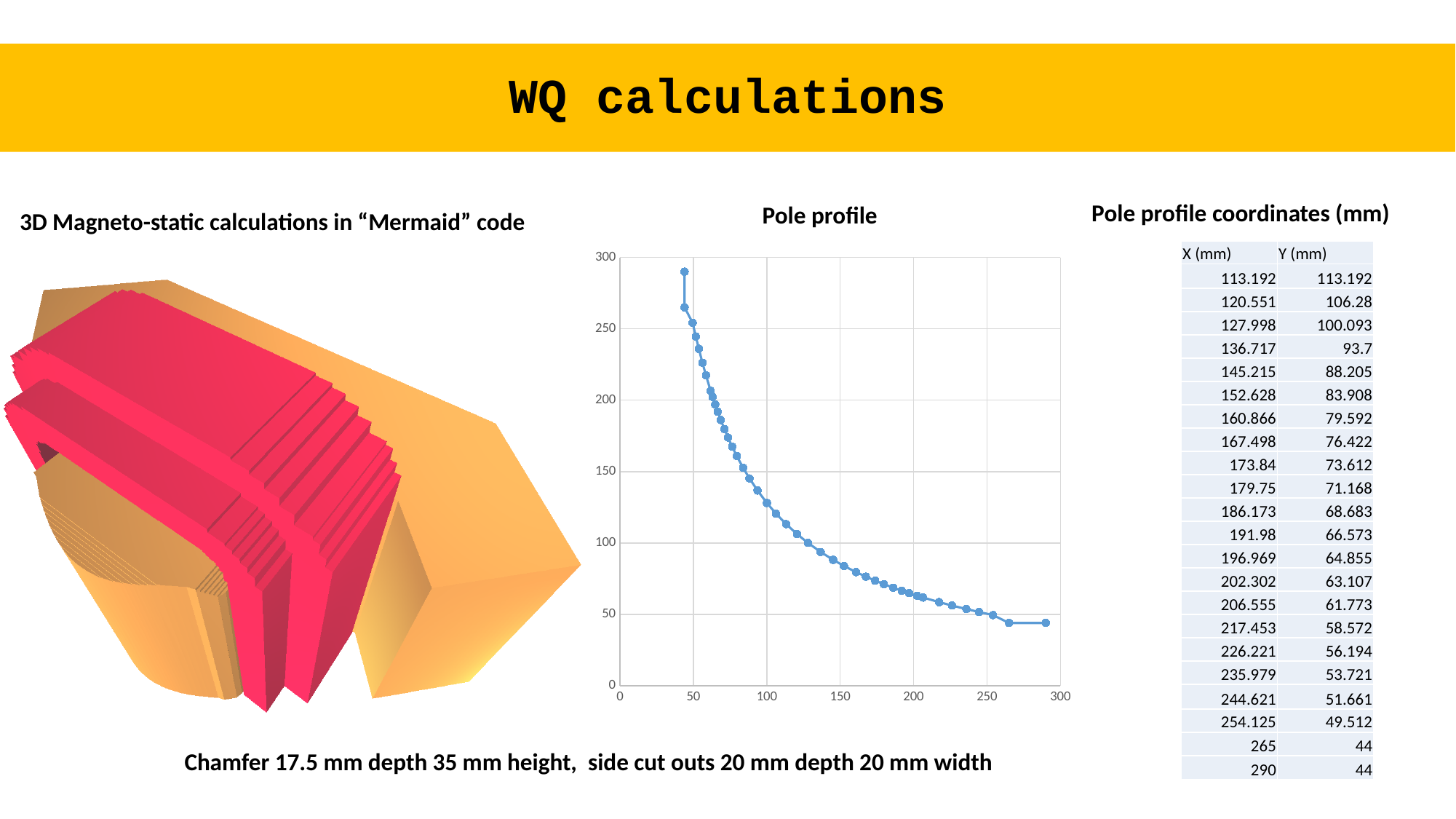
What is the title of the chart on the slide? Pole profile In the "Pole profile" chart, is the y value of the point at x = 200 greater or less than 50? greater In the "Pole profile" chart, is the y value of the point at x = 200 greater or less than 100? less In the "Pole profile" chart, which point has the higher y value: the one at x = 100 or the one at x = 200? the one at x = 100 In the "Pole profile" chart, do the plotted values rise or fall as the x value increases? fall What kind of chart is the "Pole profile" chart? line chart In the "Pole profile" chart, is the y value of the point at x = 100 greater or less than 100? greater What is the maximum value shown on the y axis of the "Pole profile" chart? 300